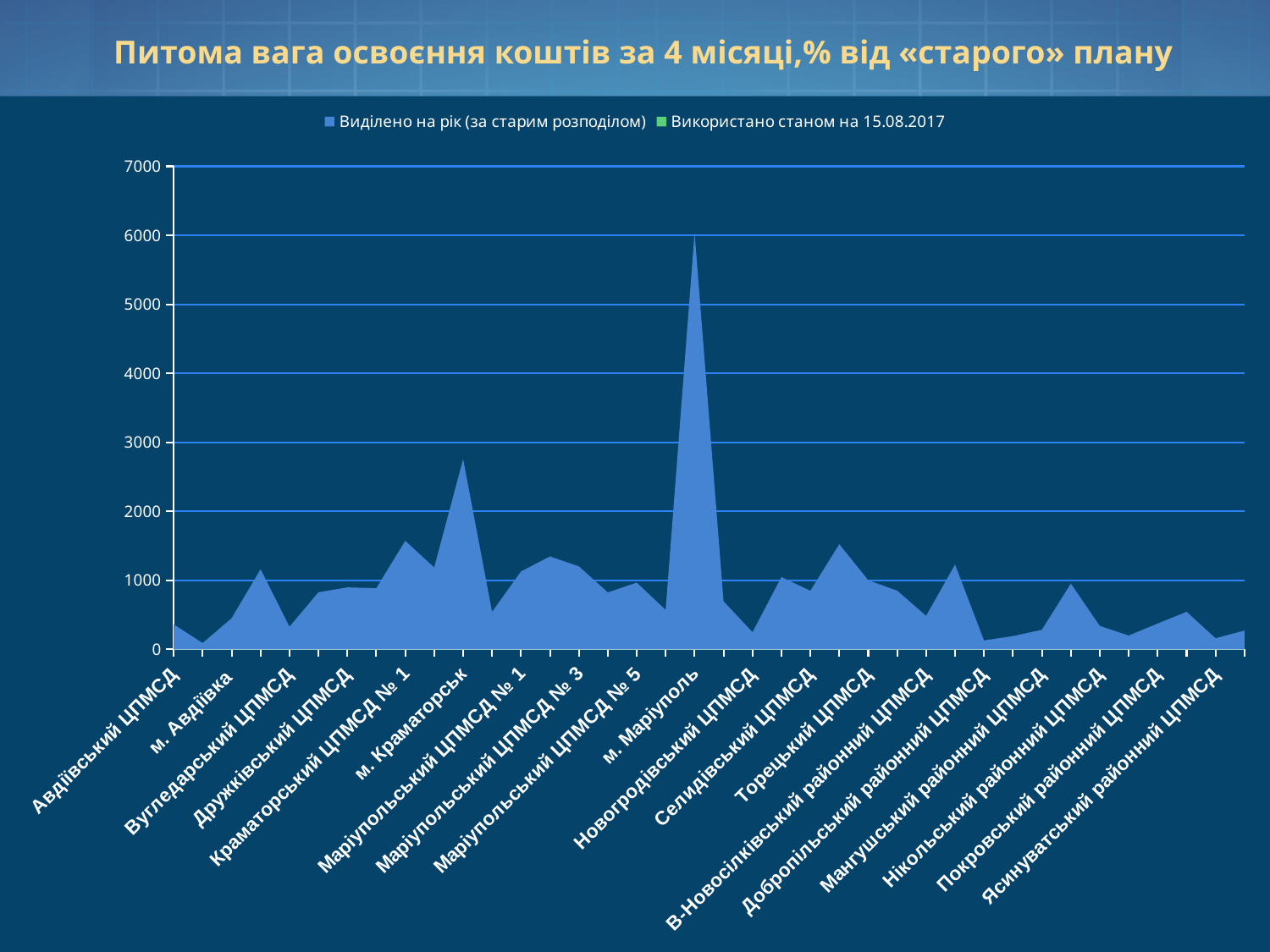
Is the value for Ясинуватський районний ЦПМСД greater or less than 1000? less Which is larger, the value for Торецький ЦПМСД or the value for Новогродівський ЦПМСД? Торецький ЦПМСД Which category has the highest value for 'Виділено на рік (за старим розподілом)'? м. Маріуполь How many series does the legend list? 2 What kind of chart is shown on the slide? area chart What is the title of the chart? Питома вага освоєння коштів за 4 місяці,% від «старого» плану Is the value for Новогродівський ЦПМСД greater or less than 1000? less Which is larger, the value for м. Маріуполь or the value for м. Краматорськ? м. Маріуполь Is the value for м. Краматорськ greater or less than 3000? less